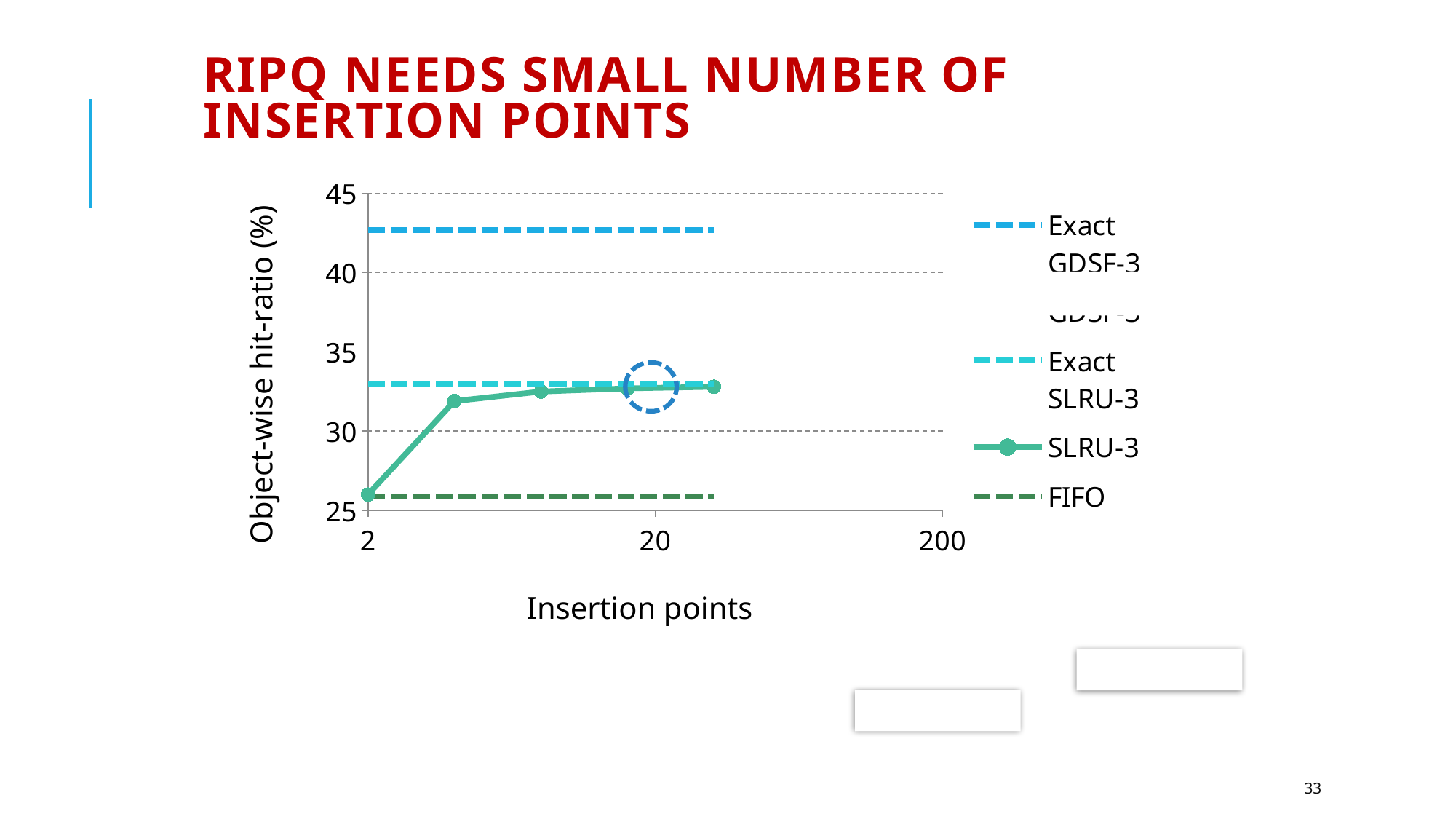
Is the value of the FIFO line greater or less than 30? less What is the label of the y axis? Object-wise hit-ratio (%) Which series has the lowest object-wise hit-ratio? FIFO Is the value of the Exact GDSF-3 line greater or less than 40? greater What kind of chart is shown on the slide? line chart Is the SLRU-3 value at 2 insertion points greater or less than 30? less Which series has the highest object-wise hit-ratio? Exact GDSF-3 Does the SLRU-3 hit-ratio rise or fall as the number of insertion points increases? rise Which is higher, the Exact GDSF-3 line or the Exact SLRU-3 line? Exact GDSF-3 What is the label of the x axis? Insertion points